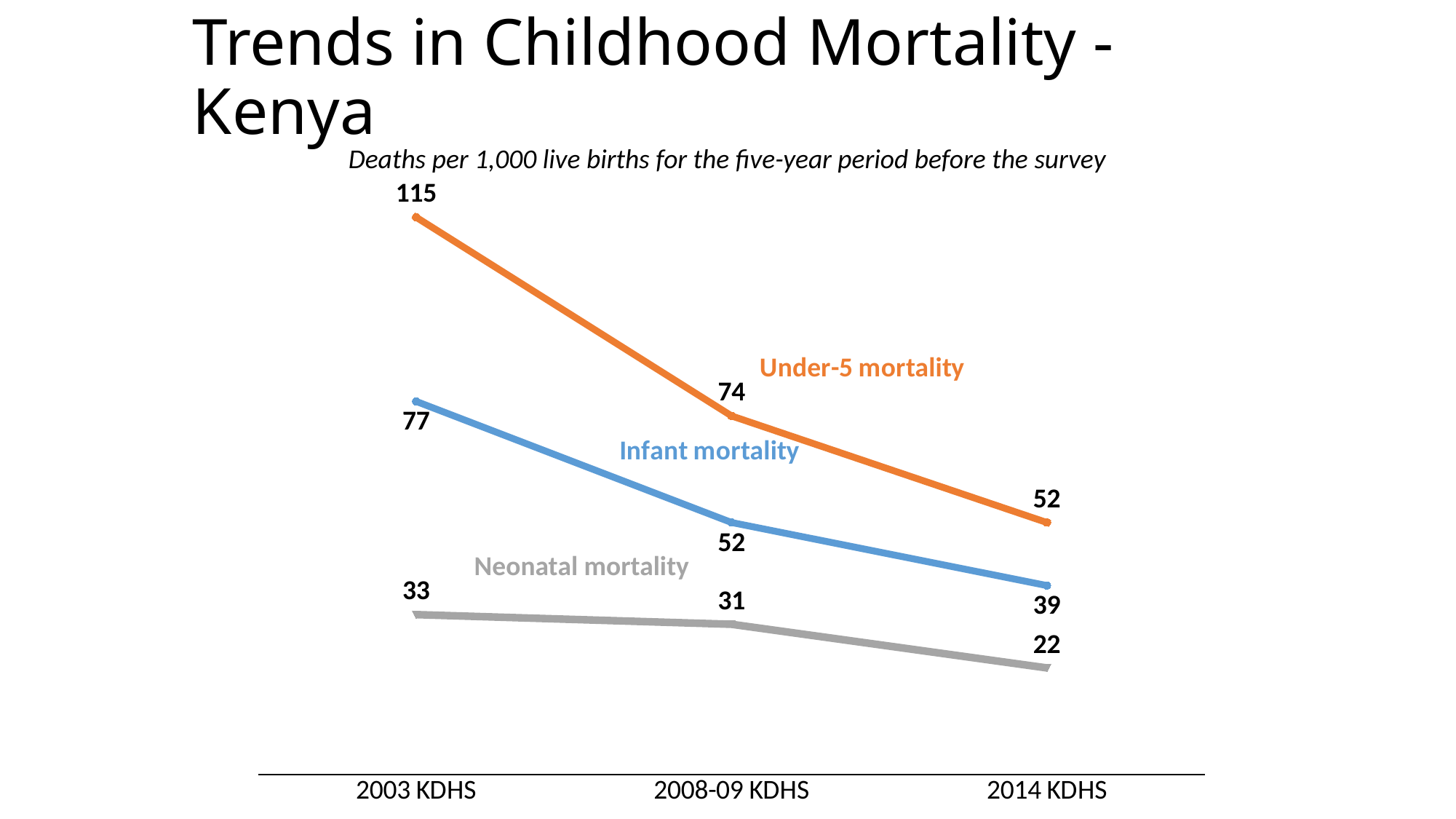
Do the infant mortality values rise or fall from the 2003 KDHS to the 2014 KDHS? Fall What is the neonatal mortality value for the 2008-09 KDHS? 31 By how much did under-5 mortality fall between the 2003 KDHS and the 2014 KDHS? 63 What is the difference between infant mortality and neonatal mortality in the 2008-09 KDHS? 21 How many surveys are shown on the x axis? 3 Which survey has the highest under-5 mortality? 2003 KDHS Which is larger in the 2014 KDHS: under-5 mortality or infant mortality? Under-5 mortality What is the under-5 mortality value for the 2003 KDHS? 115 How many series are plotted on the chart? 3 What is the infant mortality value for the 2014 KDHS? 39 What kind of chart is shown on the slide? Line chart Which survey has the lowest neonatal mortality? 2014 KDHS